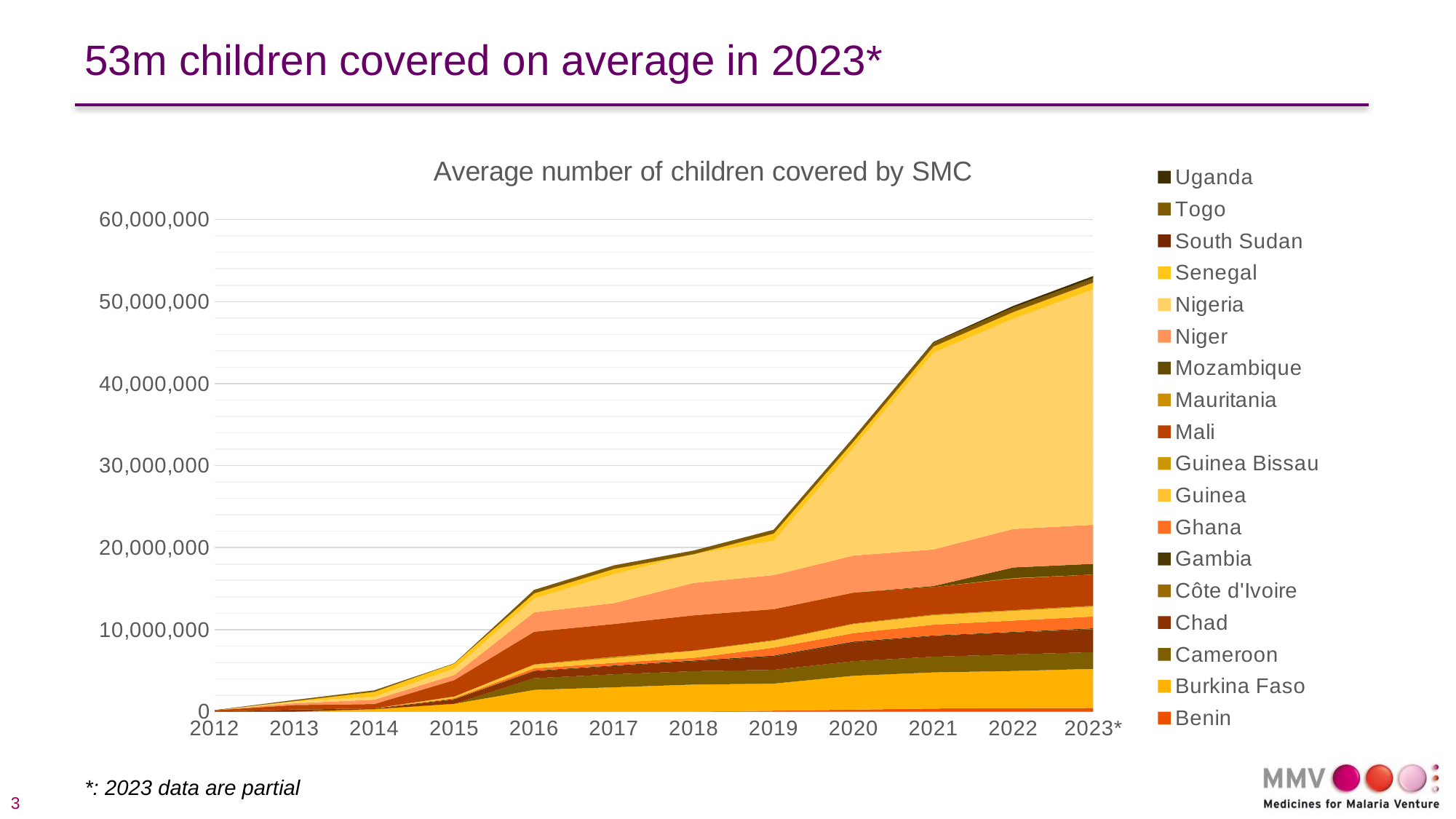
In which year is the total number of children covered lowest? 2012 Does the total number of children covered rise or fall from 2012 to 2023*? Rise How many years are shown along the x axis of the chart? 12 Is the total number of children covered in 2016 greater or less than 10,000,000? greater What kind of chart is shown on the slide? Stacked area chart Is the total number of children covered in 2023* greater or less than 50,000,000? greater Is the total number of children covered in 2019 greater or less than 30,000,000? less Which country accounts for the largest share of children covered in 2023*? Nigeria How many countries does the chart's legend list? 18 What is the title of the chart? Average number of children covered by SMC Which is larger, the total number of children covered in 2020 or in 2018? 2020 In which year is the total number of children covered highest? 2023*